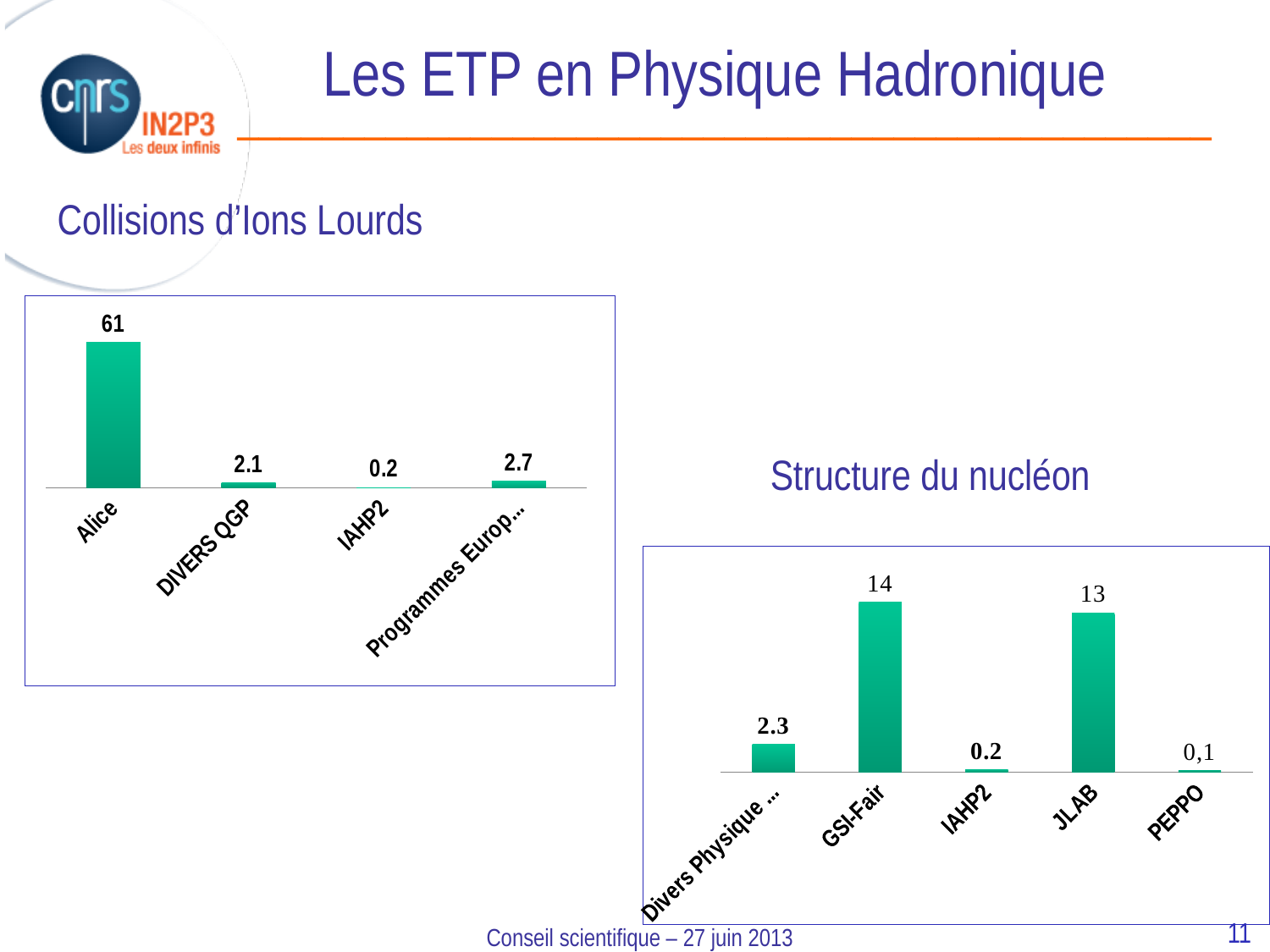
In the Structure du nucléon chart, which category has the highest value? GSI-Fair In the Collisions d'Ions Lourds chart, which category has the highest value? Alice In the Collisions d'Ions Lourds chart, what is the value for Alice? 61 What type of chart is the Structure du nucléon chart? Bar chart In the Structure du nucléon chart, what is the value for JLAB? 13 In the Collisions d'Ions Lourds chart, which category has the lowest value? IAHP2 In the Collisions d'Ions Lourds chart, what is the value for DIVERS QGP? 2.1 In the Collisions d'Ions Lourds chart, how many categories are shown? 4 In the Structure du nucléon chart, what is the value for GSI-Fair? 14 In the Collisions d'Ions Lourds chart, what is the difference between the values for Alice and DIVERS QGP? 58.9 In the Structure du nucléon chart, what is the value for PEPPO? 0,1 In the Structure du nucléon chart, which is larger, the value for GSI-Fair or the value for JLAB? GSI-Fair